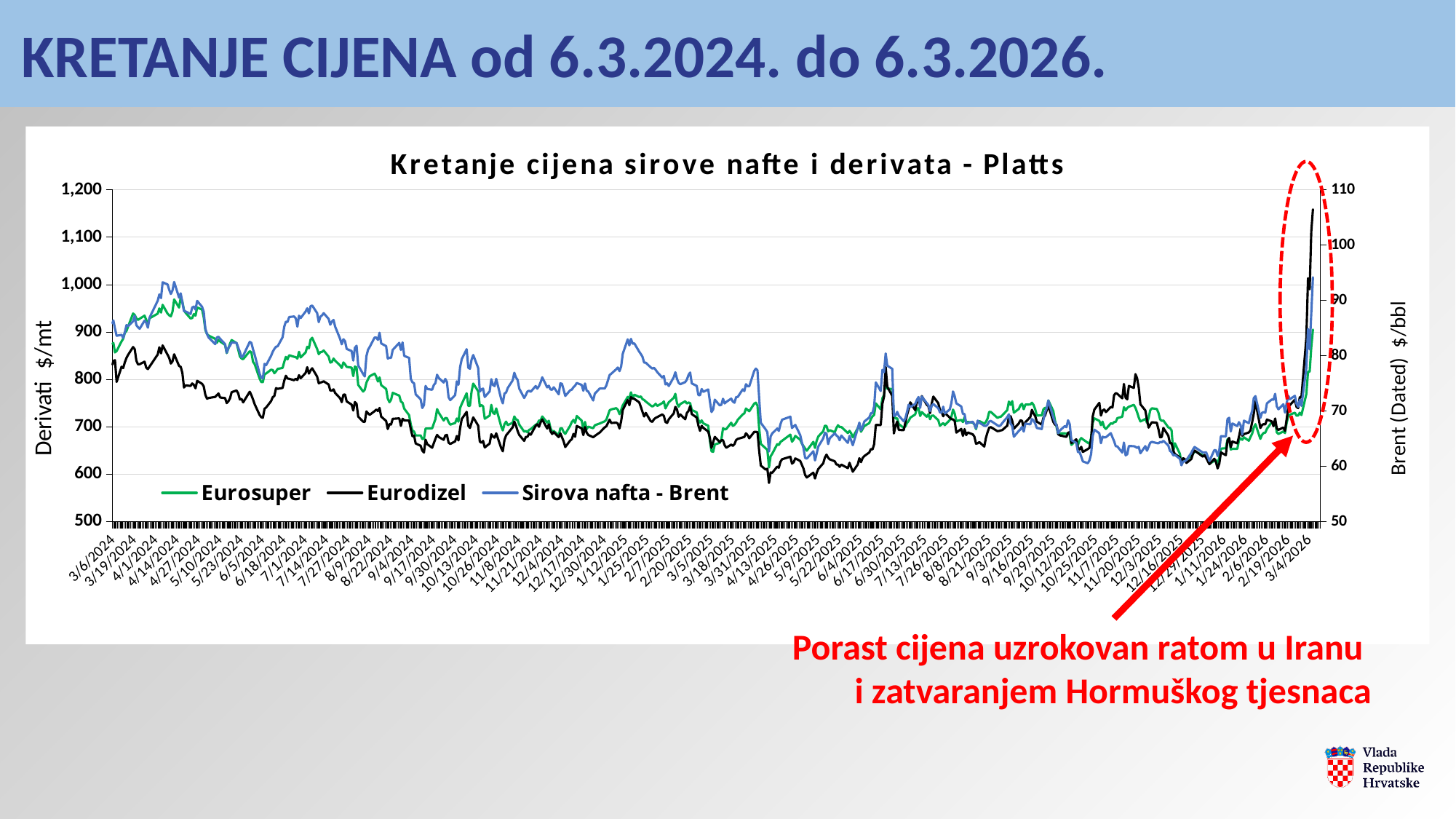
What is the label of the left vertical axis? Derivati $/mt Do the Eurosuper values rise or fall from 3/6/2024 to 9/17/2024? fall Is the value for Eurodizel at 3/6/2024 greater or less than 800? greater How many series does the chart legend list? 3 What is the title of the chart? Kretanje cijena sirove nafte i derivata - Platts Which of the two derivative series, Eurosuper or Eurodizel, reaches the highest value on the left axis? Eurodizel Is the value for Sirova nafta - Brent at 3/4/2026 greater or less than 100 on the right axis? less What kind of chart is shown on the slide? line chart Is the value for Sirova nafta - Brent at 3/6/2024 greater or less than 80 on the right axis? greater At 3/4/2026, which is higher, Eurodizel or Eurosuper? Eurodizel